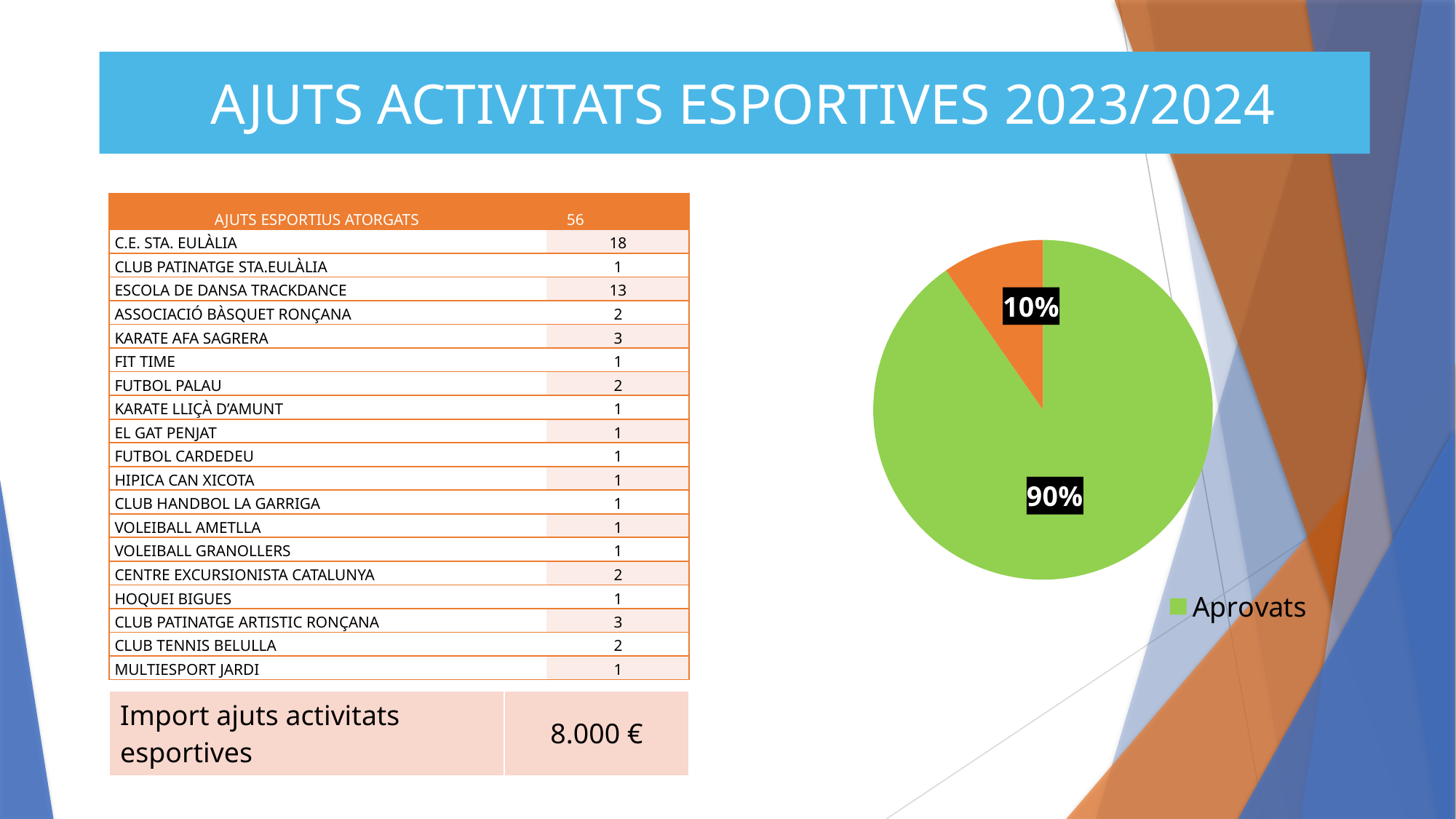
What is the share of the Aprovats slice in the pie chart? 90% What is the legend entry shown for the pie chart? Aprovats What share of the pie chart does the green slice represent? 90% Which slice of the pie chart is the largest? Aprovats (90%) What is the difference in percentage points between the two slices of the pie chart? 80 Which is larger in the pie chart, the green slice or the orange slice? the green slice How many entries does the pie chart's legend list? 1 What kind of chart is shown on the slide? pie chart What share of the pie chart does the orange slice represent? 10% Which slice of the pie chart is the smallest? the orange slice (10%) What colour is the Aprovats slice in the pie chart? green How many slices does the pie chart have? 2